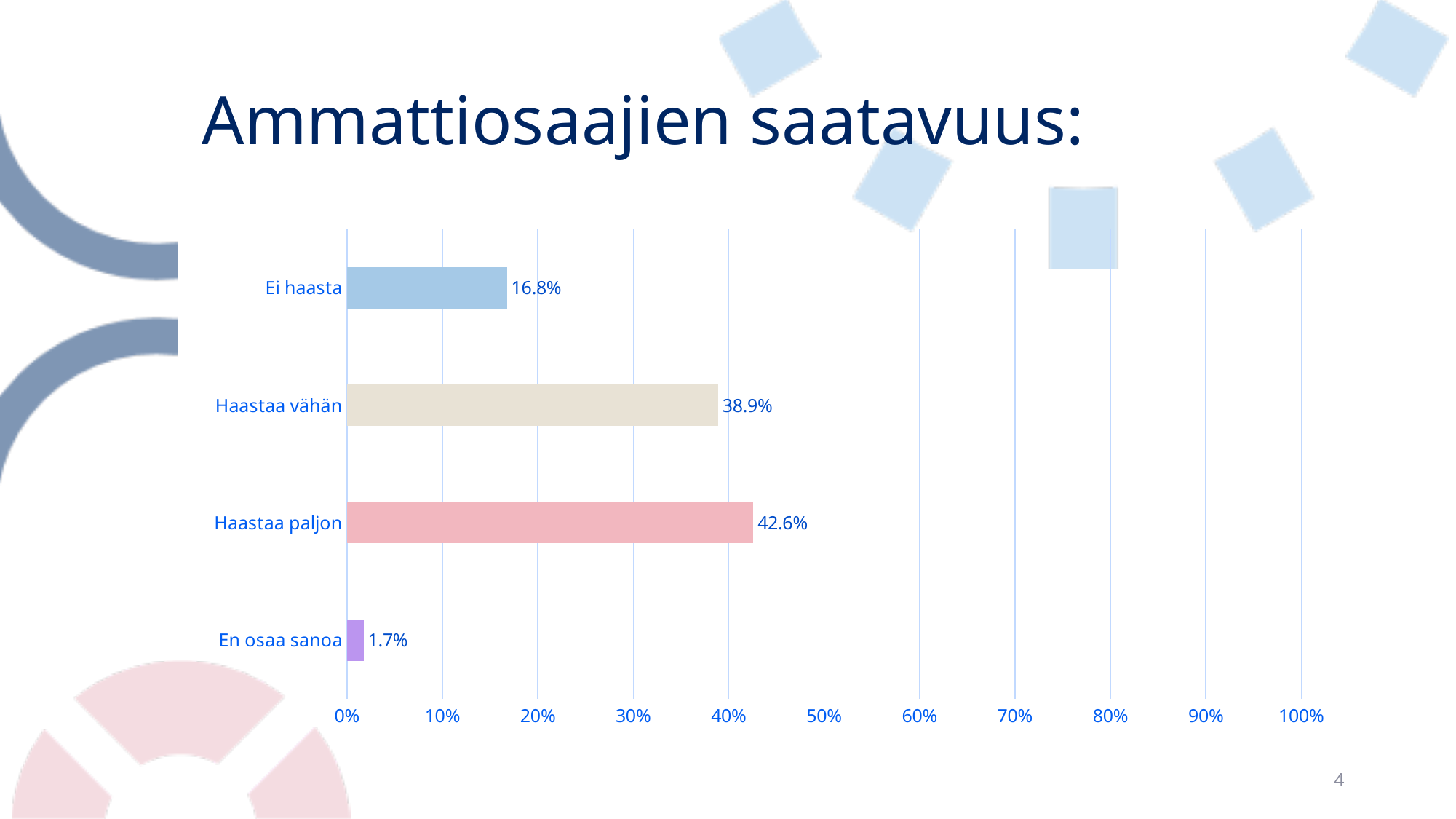
What kind of chart is shown on the slide? bar chart Is the value for Haastaa paljon greater or less than 40%? greater What is the value for En osaa sanoa? 1.7% What is the value for Haastaa paljon? 42.6% Which category has the highest value? Haastaa paljon Which category has the lowest value? En osaa sanoa What is the difference between the values for Ei haasta and En osaa sanoa? 15.1% How many categories are shown in the chart? 4 What is the value for Ei haasta? 16.8% Which is larger, the value for Ei haasta or the value for Haastaa vähän? Haastaa vähän What is the difference between the values for Haastaa paljon and Haastaa vähän? 3.7% What is the value for Haastaa vähän? 38.9%